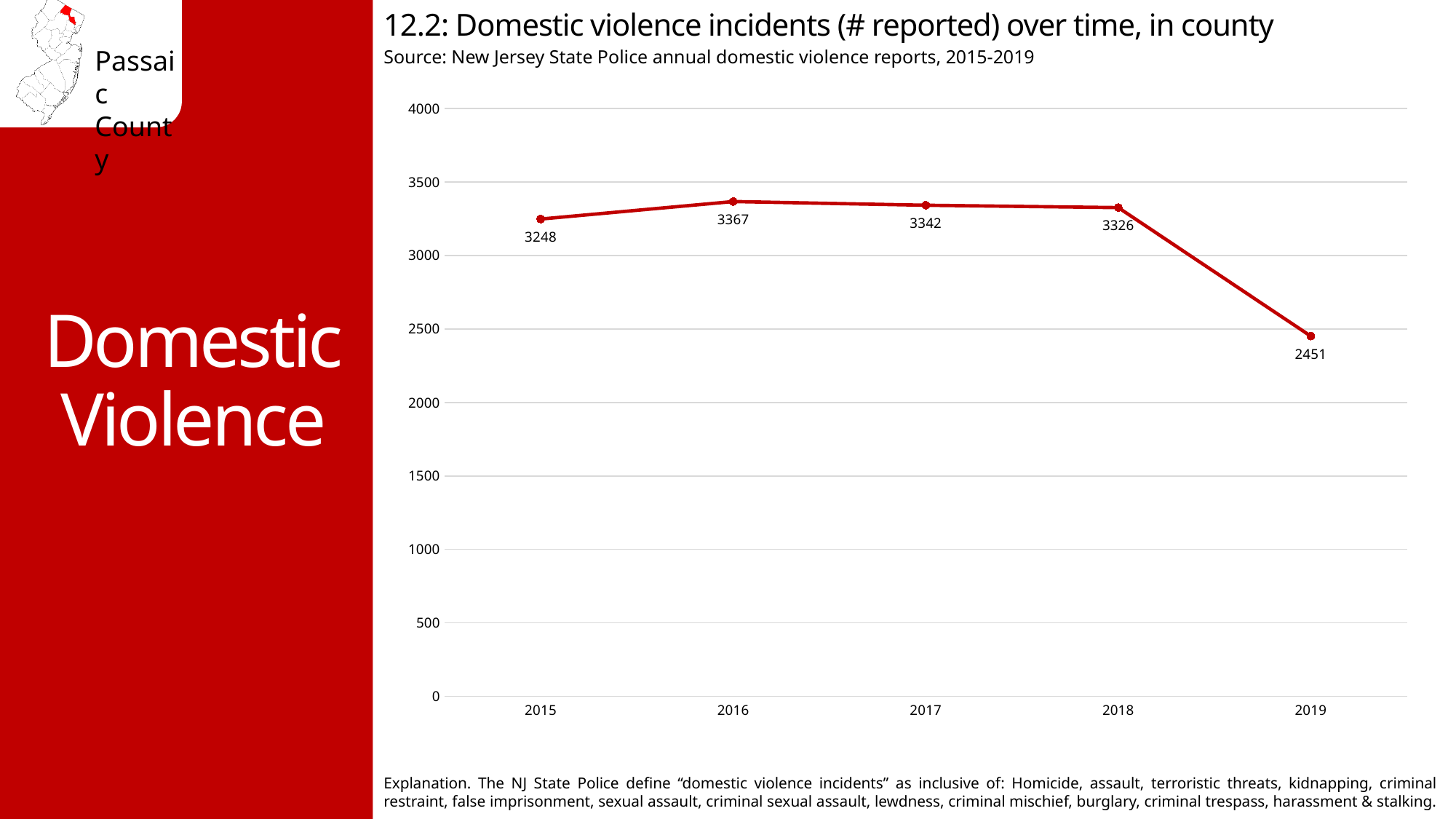
How many years are plotted on the chart? 5 What kind of chart is shown on the slide? line chart Which year had more reported incidents, 2015 or 2018? 2018 What was the number of reported domestic violence incidents in 2019? 2451 What is the difference in reported incidents between 2016 and 2015? 119 What is the difference in reported incidents between 2018 and 2019? 875 What was the number of reported domestic violence incidents in 2017? 3342 Which year had the lowest number of reported domestic violence incidents? 2019 What was the number of reported domestic violence incidents in 2015? 3248 What is the source of the data shown in the chart? New Jersey State Police annual domestic violence reports, 2015-2019 Is the value for 2019 greater or less than 3000? less Which year had the highest number of reported domestic violence incidents? 2016